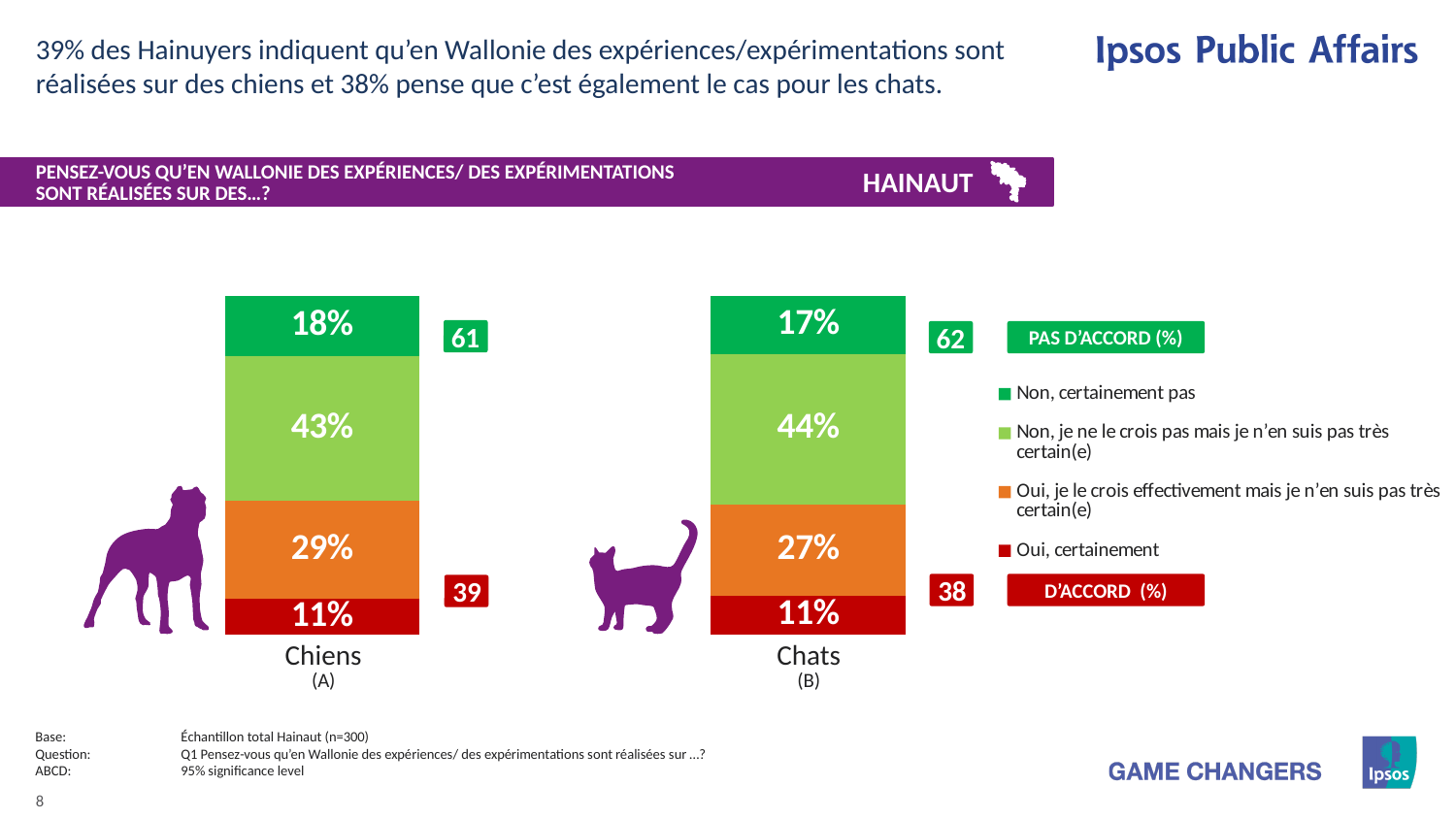
What percentage of respondents answered "Non, certainement pas" for Chiens? 18% Which response category has the smallest share in the Chats bar? Oui, certainement What is the difference between the "Oui, je le crois effectivement mais je n'en suis pas très certain(e)" values for Chiens and Chats? 2 percentage points Which response category has the largest share in the Chiens bar? Non, je ne le crois pas mais je n'en suis pas très certain(e) What kind of chart is shown on the slide? Stacked bar chart What is the total "Pas d'accord (%)" value shown for Chats? 62 What is the total "D'accord (%)" value shown for Chiens? 39 Which is larger: the "Non, certainement pas" value for Chiens or for Chats? Chiens What percentage of respondents answered "Oui, certainement" for Chiens? 11% What percentage of respondents answered "Oui, je le crois effectivement mais je n'en suis pas très certain(e)" for Chats? 27% What percentage of respondents answered "Non, je ne le crois pas mais je n'en suis pas très certain(e)" for Chats? 44% How many series does the legend list? 4